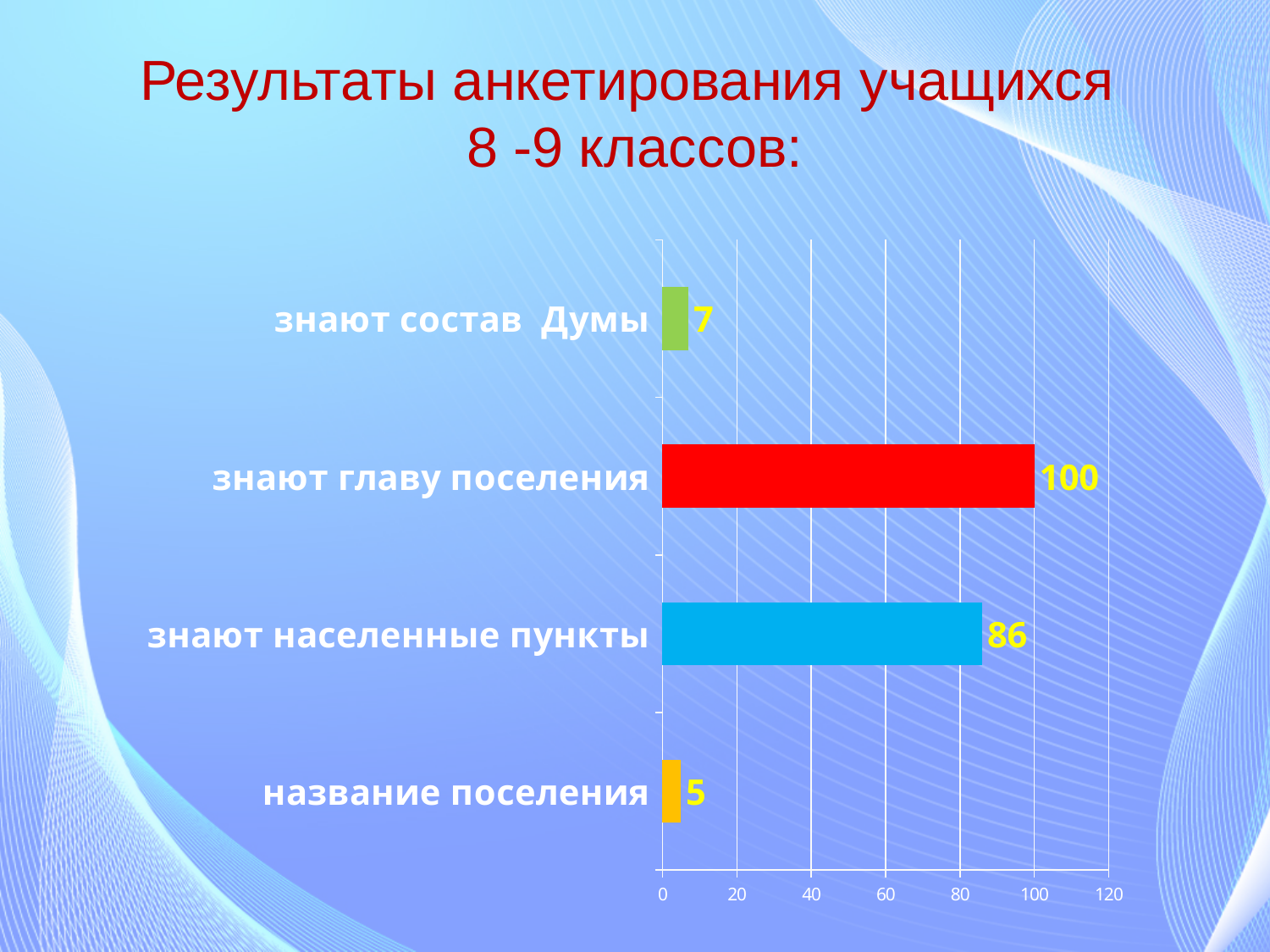
Which is larger, the value for "знают состав Думы" or the value for "название поселения"? знают состав Думы Which category has the highest value? знают главу поселения What colour is the bar for "знают главу поселения"? red What is the value for "знают населенные пункты"? 86 What is the value for "название поселения"? 5 What is the value for "знают состав Думы"? 7 Is the value for "знают населенные пункты" greater or less than 80? greater Which category has the lowest value? название поселения What is the difference between the values for "знают главу поселения" and "знают населенные пункты"? 14 What kind of chart is shown on the slide? bar chart What is the value for "знают главу поселения"? 100 How many categories are shown in the chart? 4